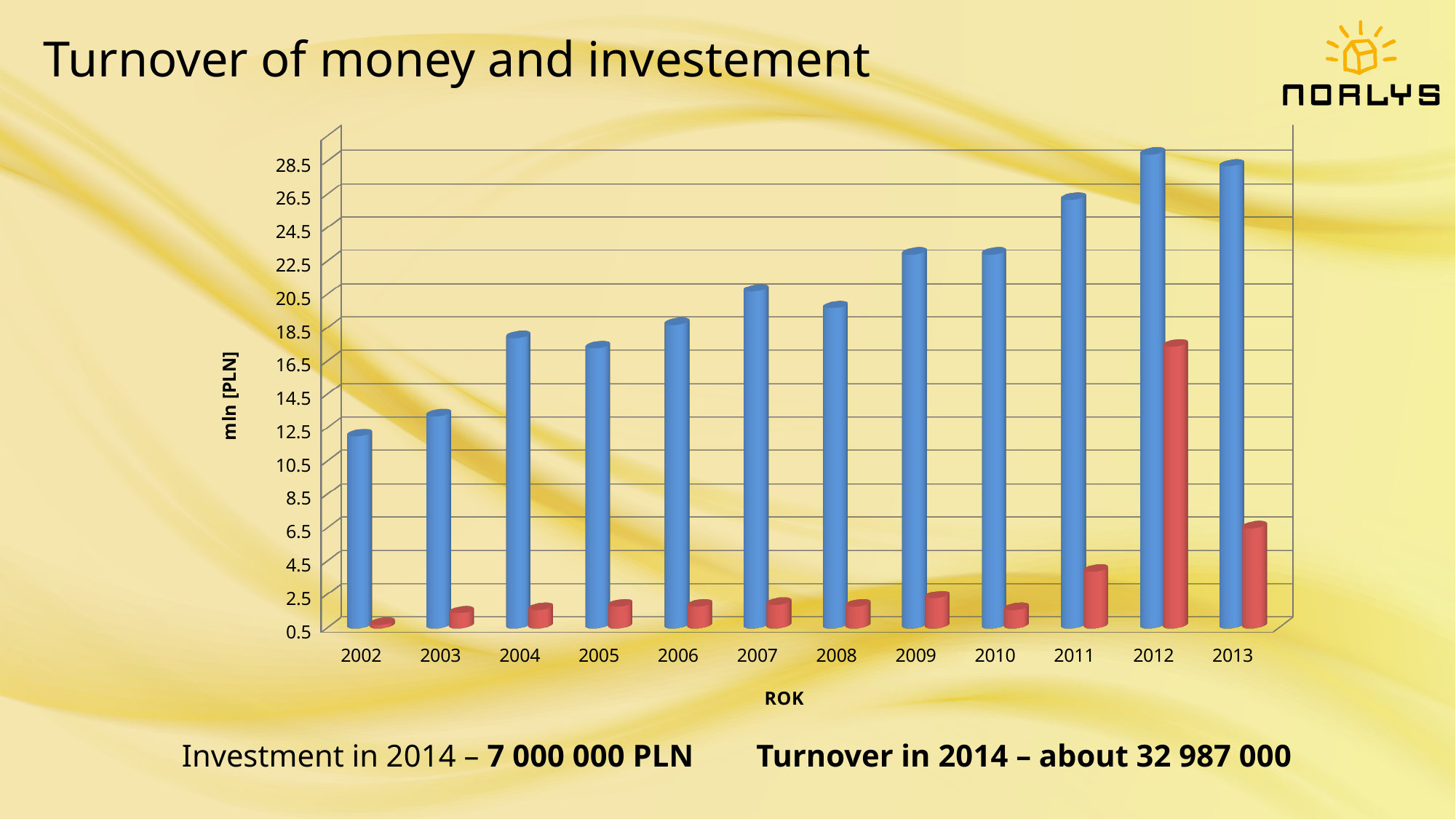
What is the label on the vertical axis of the chart? mln [PLN] Which year has the taller red bar, 2011 or 2012? 2012 Is the blue bar for 2005 greater or less than 18.5? less In which year is the blue bar the shortest? 2002 What is the title of the slide's chart? Turnover of money and investement In which year is the red bar the tallest? 2012 How many years are shown on the x axis of the chart? 12 In which year is the blue bar the tallest? 2012 What kind of chart is shown on the slide? bar chart Is the red bar for 2012 greater or less than 14.5? greater Do the blue bars generally rise or fall from 2002 to 2013? rise Is the blue bar for 2011 greater or less than 24.5? greater